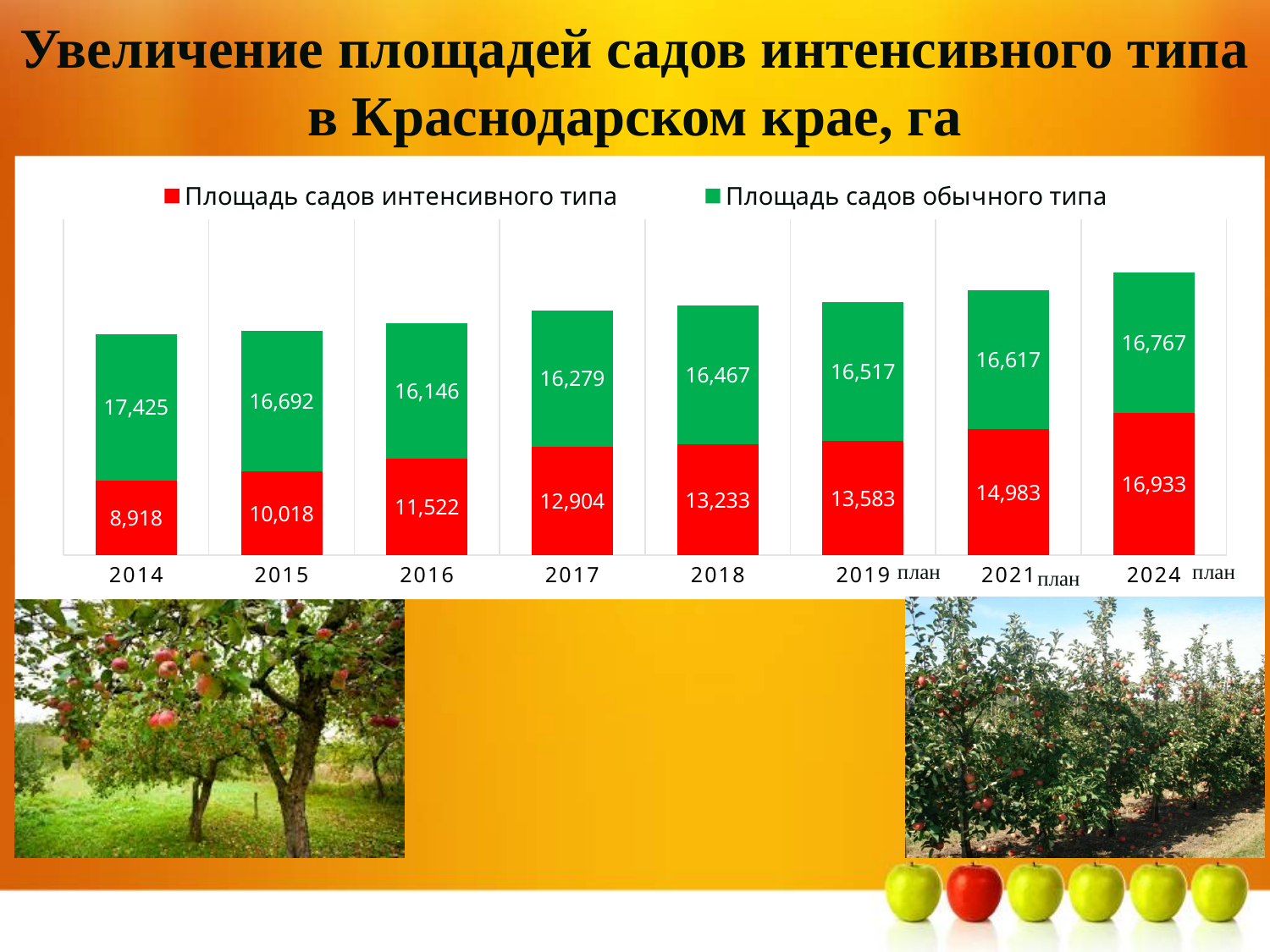
What kind of chart is shown on the slide? Stacked bar chart What is the total of the stacked bar for 2017? 29,183 Which is larger in 2016: Площадь садов интенсивного типа or Площадь садов обычного типа? Площадь садов обычного типа How many years (categories) are shown on the x axis? 8 What is the value for Площадь садов интенсивного типа in 2014? 8,918 What is the value for Площадь садов интенсивного типа in 2024 план? 16,933 Does Площадь садов интенсивного типа rise or fall from 2014 to 2024 план? Rise In which year is Площадь садов обычного типа the highest? 2014 How many series does the legend list? 2 What is the value for Площадь садов обычного типа in 2018? 16,467 In which year is Площадь садов интенсивного типа the lowest? 2014 What is the difference between Площадь садов интенсивного типа in 2021 план and in 2018? 1,750